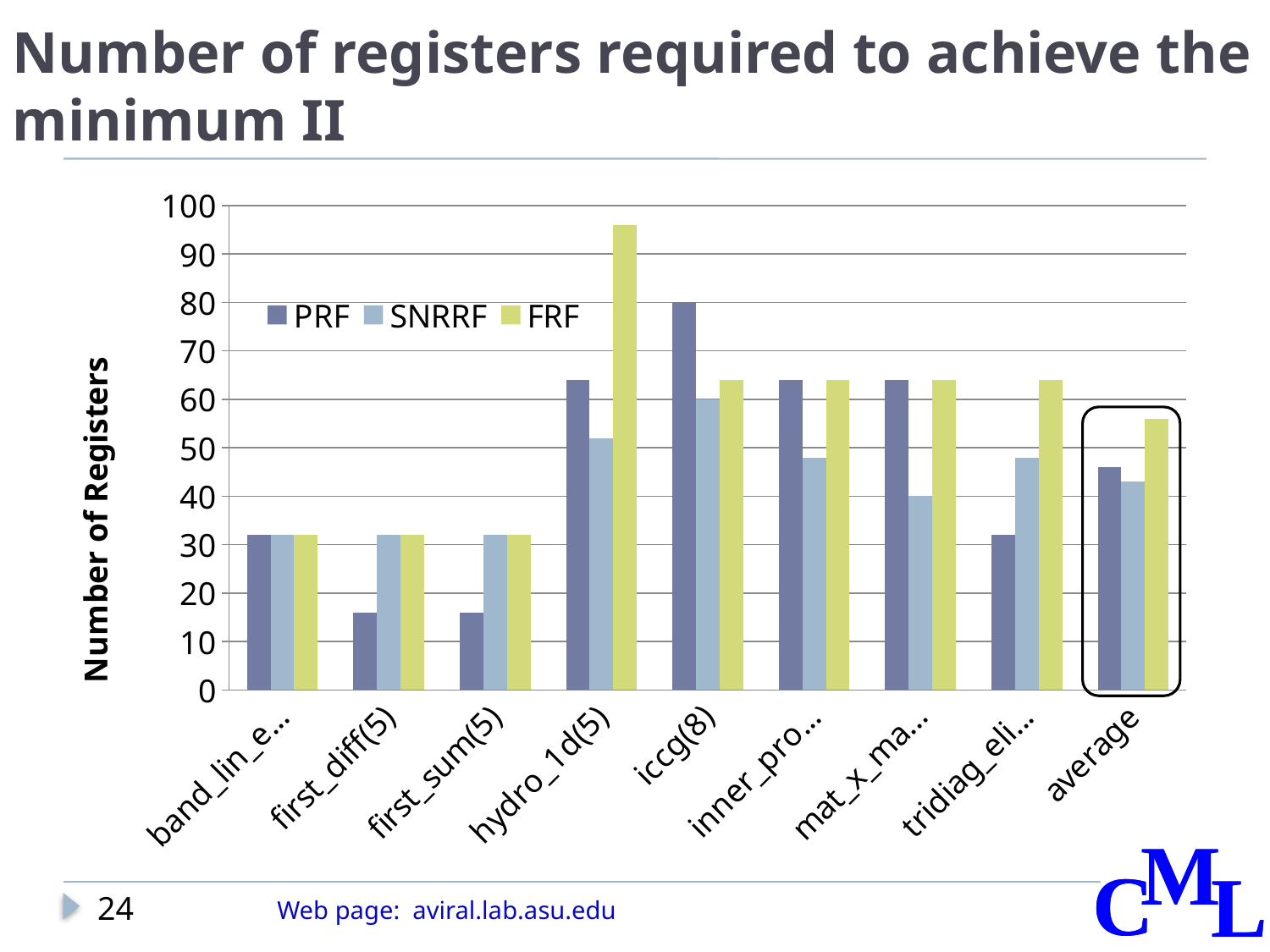
What is the SNRRF value for iccg(8)? 60 What is the title of the y axis? Number of Registers Which category has the highest FRF value? hydro_1d(5) What is the difference between the PRF and SNRRF values for iccg(8)? 20 Is the PRF value for first_diff(5) greater or less than 20? less How many series does the legend list? 3 For hydro_1d(5), which is larger, the PRF value or the FRF value? FRF How many categories are shown along the x axis? 9 Which category has the highest PRF value? iccg(8) What is the PRF value for iccg(8)? 80 Is the FRF value for hydro_1d(5) greater or less than 90? greater What kind of chart is shown on the slide? bar chart